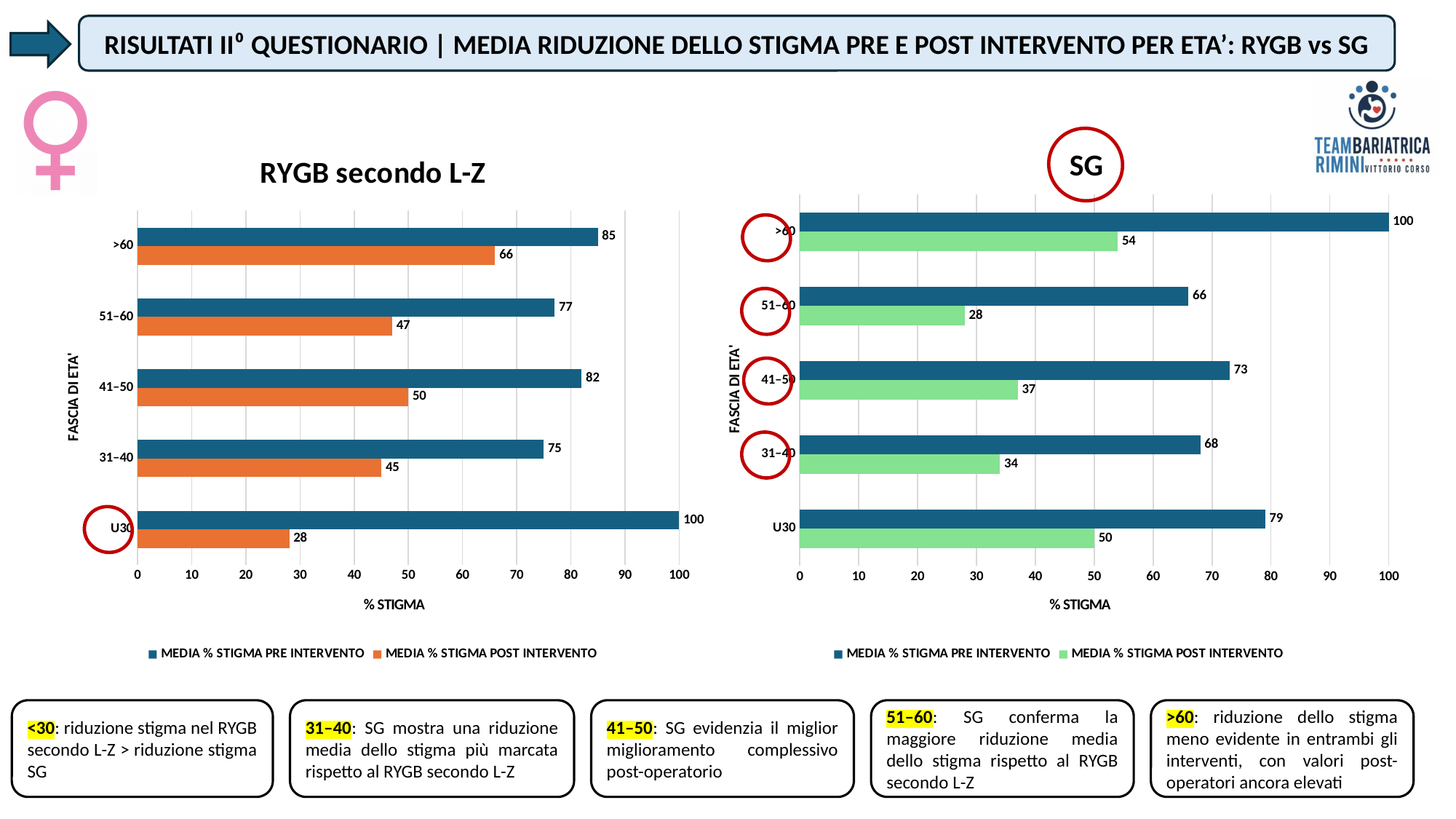
In the RYGB secondo L-Z chart, which age group has the highest MEDIA % STIGMA POST INTERVENTO value? >60 In the SG chart, what is the MEDIA % STIGMA POST INTERVENTO value for the >60 age group? 54 In the SG chart, what is the MEDIA % STIGMA PRE INTERVENTO value for the 31–40 age group? 68 In the RYGB secondo L-Z chart, what is the MEDIA % STIGMA PRE INTERVENTO value for the U30 age group? 100 In the RYGB secondo L-Z chart, what is the MEDIA % STIGMA POST INTERVENTO value for the 51–60 age group? 47 What type of chart is the SG chart? Bar chart How many age groups are shown in the RYGB secondo L-Z chart? 5 In the SG chart, what is the difference between the pre and post intervention values for the 41–50 age group? 36 How many series does the legend of the SG chart list? 2 In the RYGB secondo L-Z chart, what is the difference between the pre and post intervention values for the U30 age group? 72 In the SG chart, which is larger: the MEDIA % STIGMA POST INTERVENTO value for U30 or for 31–40? U30 In the SG chart, which age group has the lowest MEDIA % STIGMA POST INTERVENTO value? 51–60